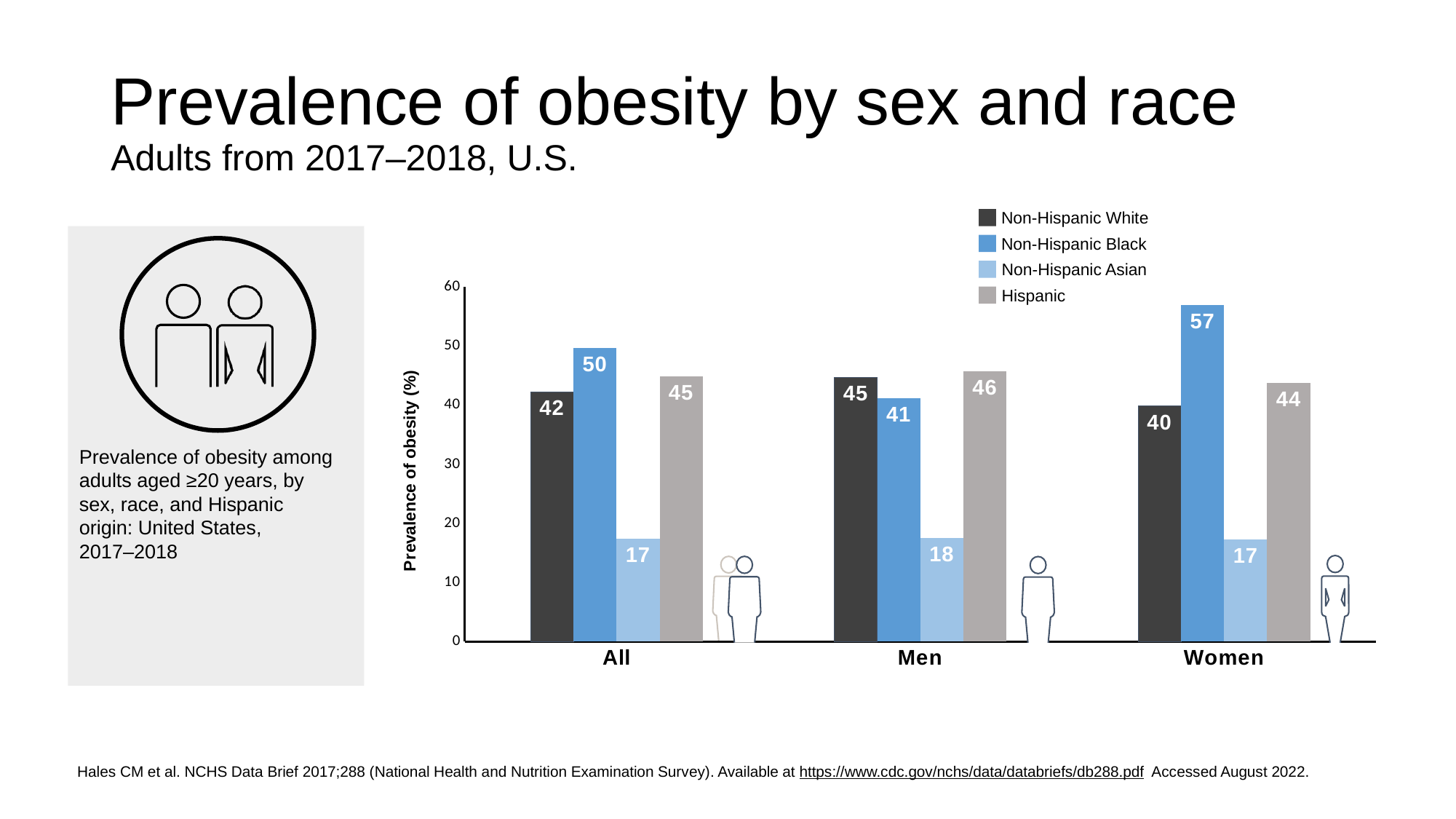
Which is larger, the prevalence of obesity for Non-Hispanic White men or Non-Hispanic White women? Non-Hispanic White men How many series does the legend list? 4 Which race group has the highest prevalence of obesity among women? Non-Hispanic Black How many categories are shown on the x axis? 3 What kind of chart is shown on the slide? Bar chart What is the prevalence of obesity for Hispanic men? 46 What is the prevalence of obesity for Non-Hispanic Black adults in the All category? 50 What is the label of the y axis? Prevalence of obesity (%) Is the value for Non-Hispanic Black women greater or less than 50? greater What is the prevalence of obesity for Non-Hispanic Asian women? 17 What is the difference between the prevalence of obesity for Non-Hispanic Black women and Non-Hispanic Black men? 16 Which race group has the lowest prevalence of obesity among men? Non-Hispanic Asian